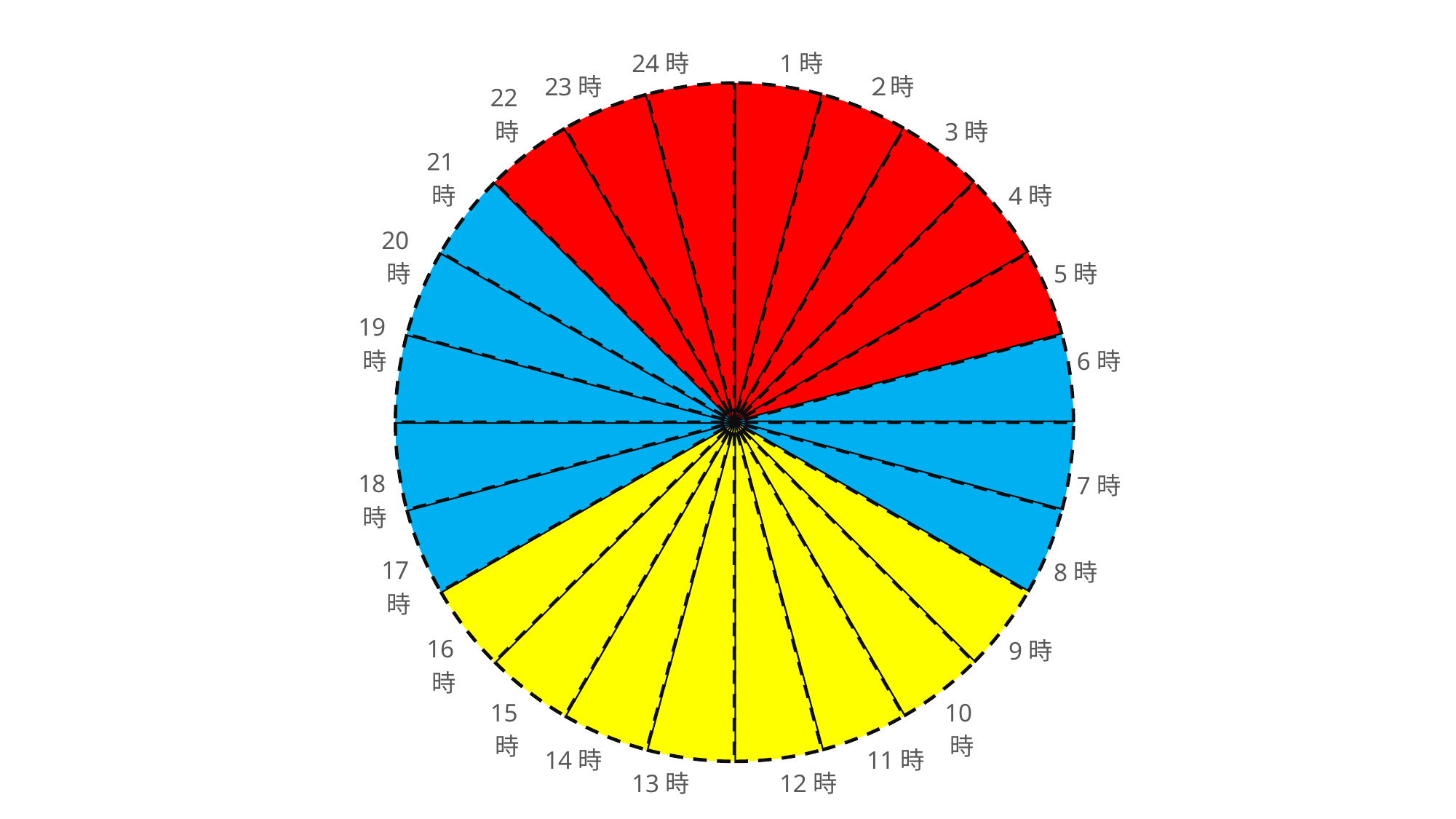
How many categories (hour labels) are shown around the chart? 24 What is the label of the first category at the top of the chart, just right of 24時? 1時 What colour is the slice labelled 3時? Red What colour is the slice labelled 12時? Yellow Which hour label comes immediately after 11時 going clockwise? 12時